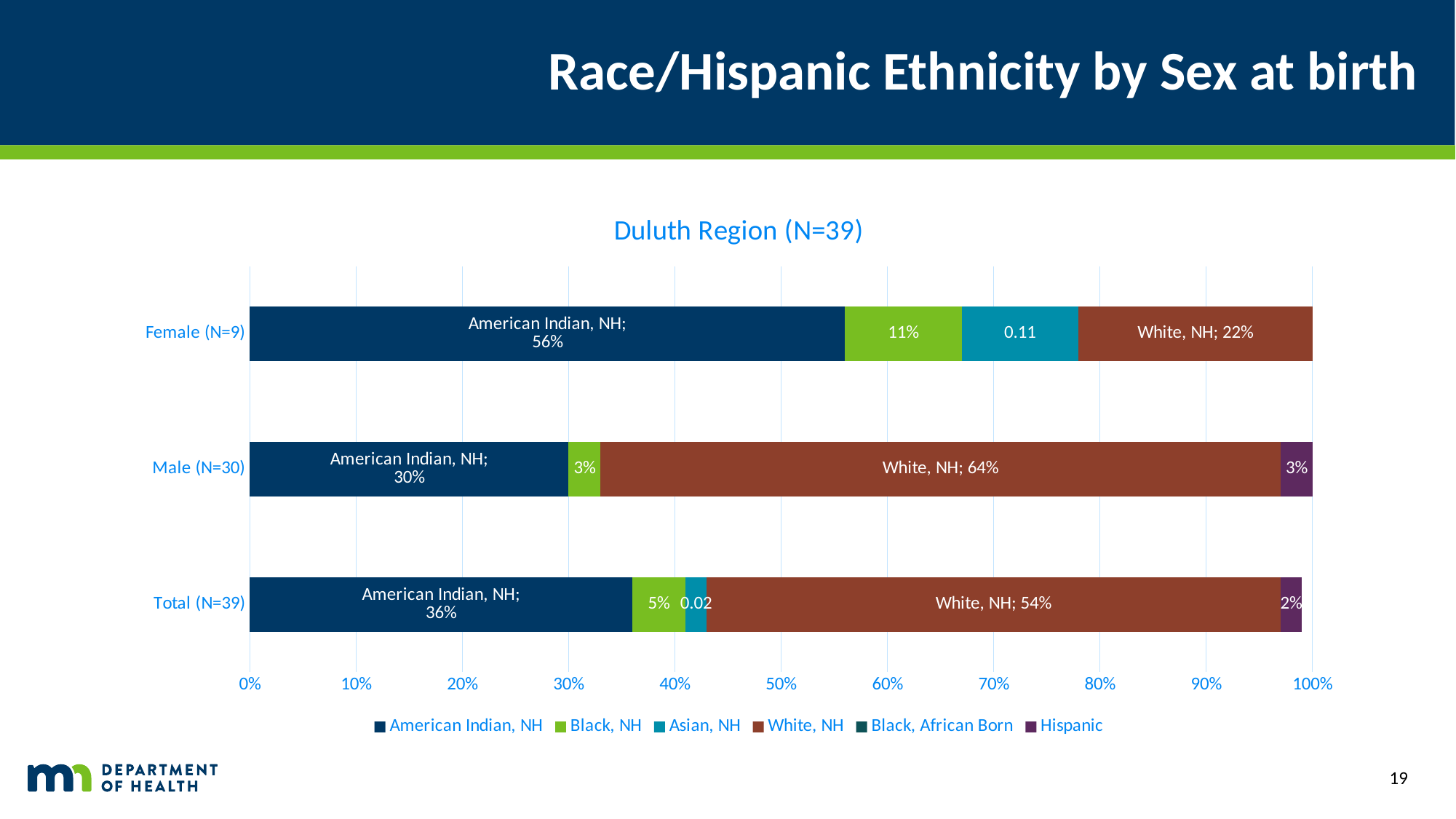
Which category has the lowest value for American Indian, NH? Male (N=30) What is the chart's title? Duluth Region (N=39) What is the value for White, NH in the Female (N=9) bar? 22% What is the difference between the American Indian, NH value for Female (N=9) and for Male (N=30)? 26% What is the value for American Indian, NH in the Female (N=9) bar? 56% What type of chart is shown on the slide? stacked bar chart Which category has the highest value for White, NH? Male (N=30) Which is larger: the Black, NH value for Female (N=9) or for Total (N=39)? Female (N=9) What is the value for Black, NH in the Total (N=39) bar? 5% How many series does the legend list? 6 What is the value for White, NH in the Male (N=30) bar? 64% How many category bars are plotted on the chart? 3